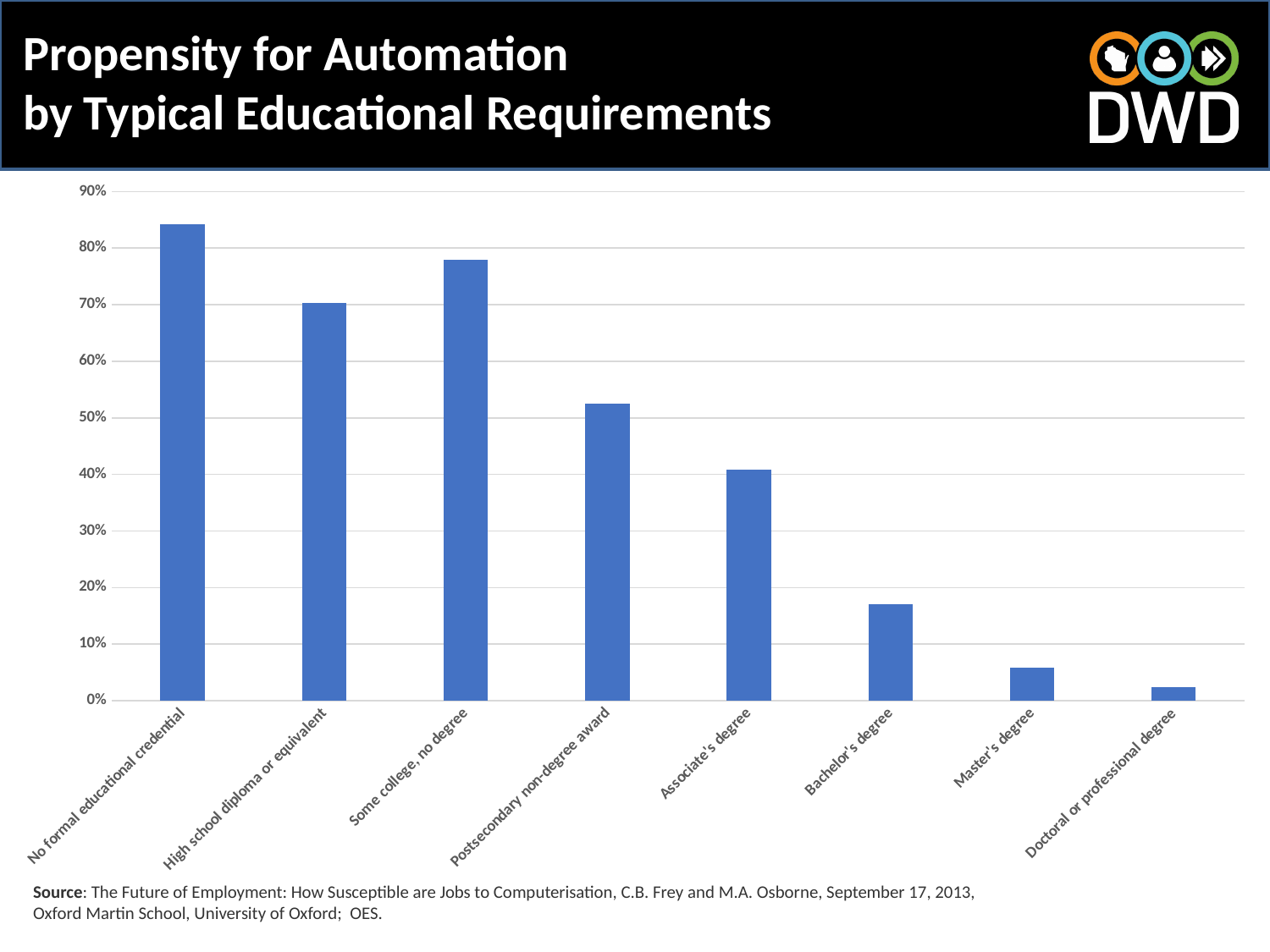
Which educational requirement category has the lowest propensity for automation? Doctoral or professional degree Is the value for Associate's degree greater or less than 50%? less How many educational requirement categories are shown on the chart? 8 Which is larger, the value for Some college, no degree or the value for High school diploma or equivalent? Some college, no degree Is the value for Bachelor's degree greater or less than 20%? less What kind of chart is shown on the slide? Bar chart What is the highest value shown on the vertical axis of the chart? 90% Which is larger, the value for Associate's degree or the value for Bachelor's degree? Associate's degree Is the value for Postsecondary non-degree award greater or less than 50%? greater Which educational requirement category has the highest propensity for automation? No formal educational credential